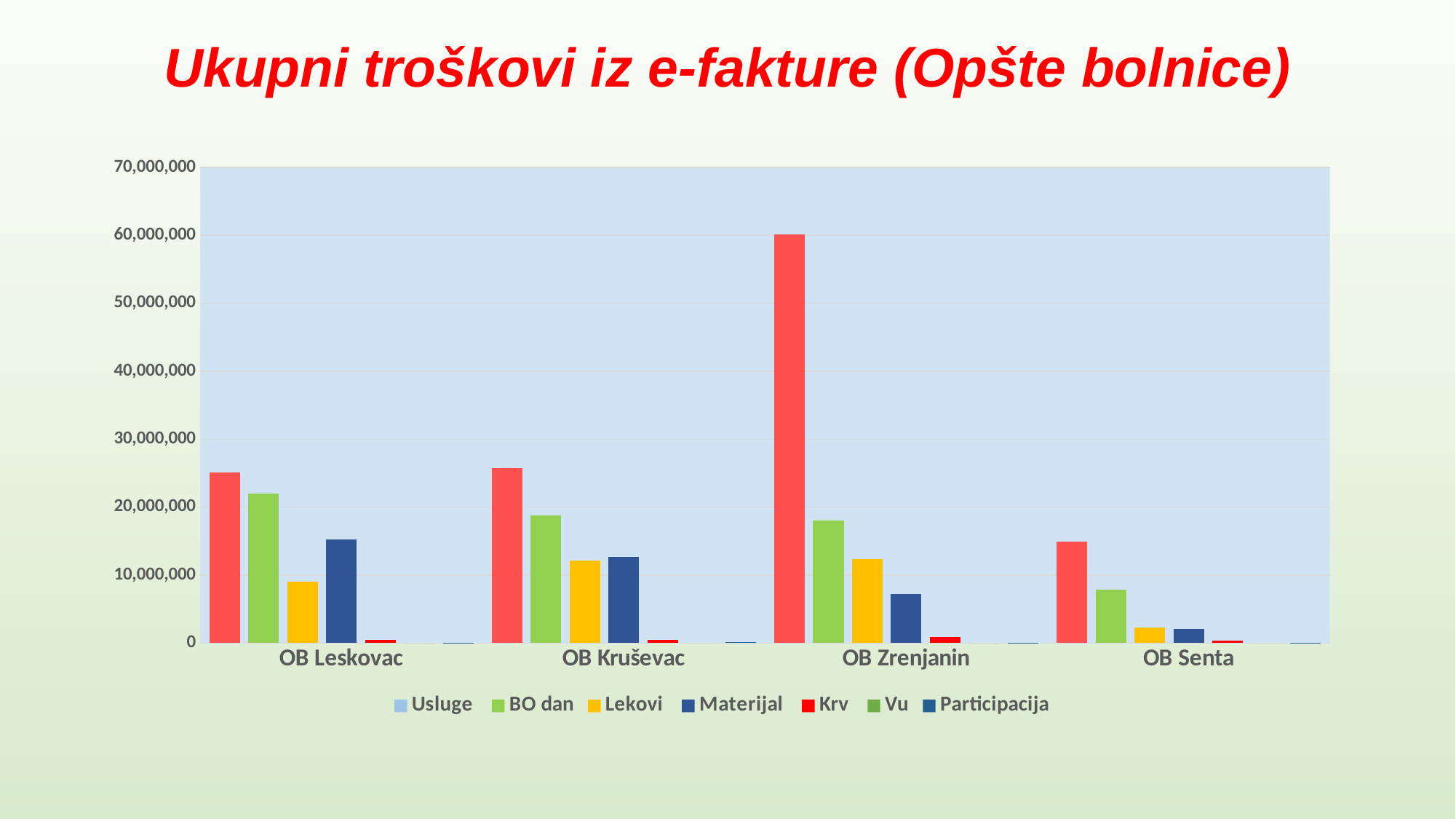
Which hospital has the lowest value for BO dan? OB Senta Which hospital group contains the tallest bar in the chart? OB Zrenjanin How many series does the legend list? 7 Which hospital has the highest value for Materijal? OB Leskovac Which is larger: Materijal at OB Leskovac or Materijal at OB Kruševac? OB Leskovac What type of chart is shown on the slide? bar chart Which hospital has the highest value for BO dan? OB Leskovac Is the value for BO dan at OB Leskovac greater or less than 20,000,000? greater Is the value for Lekovi at OB Leskovac greater or less than 10,000,000? less Which hospital has the lowest value for Lekovi? OB Senta How many hospitals (categories) are shown on the x axis? 4 What is the title of the chart? Ukupni troškovi iz e-fakture (Opšte bolnice)